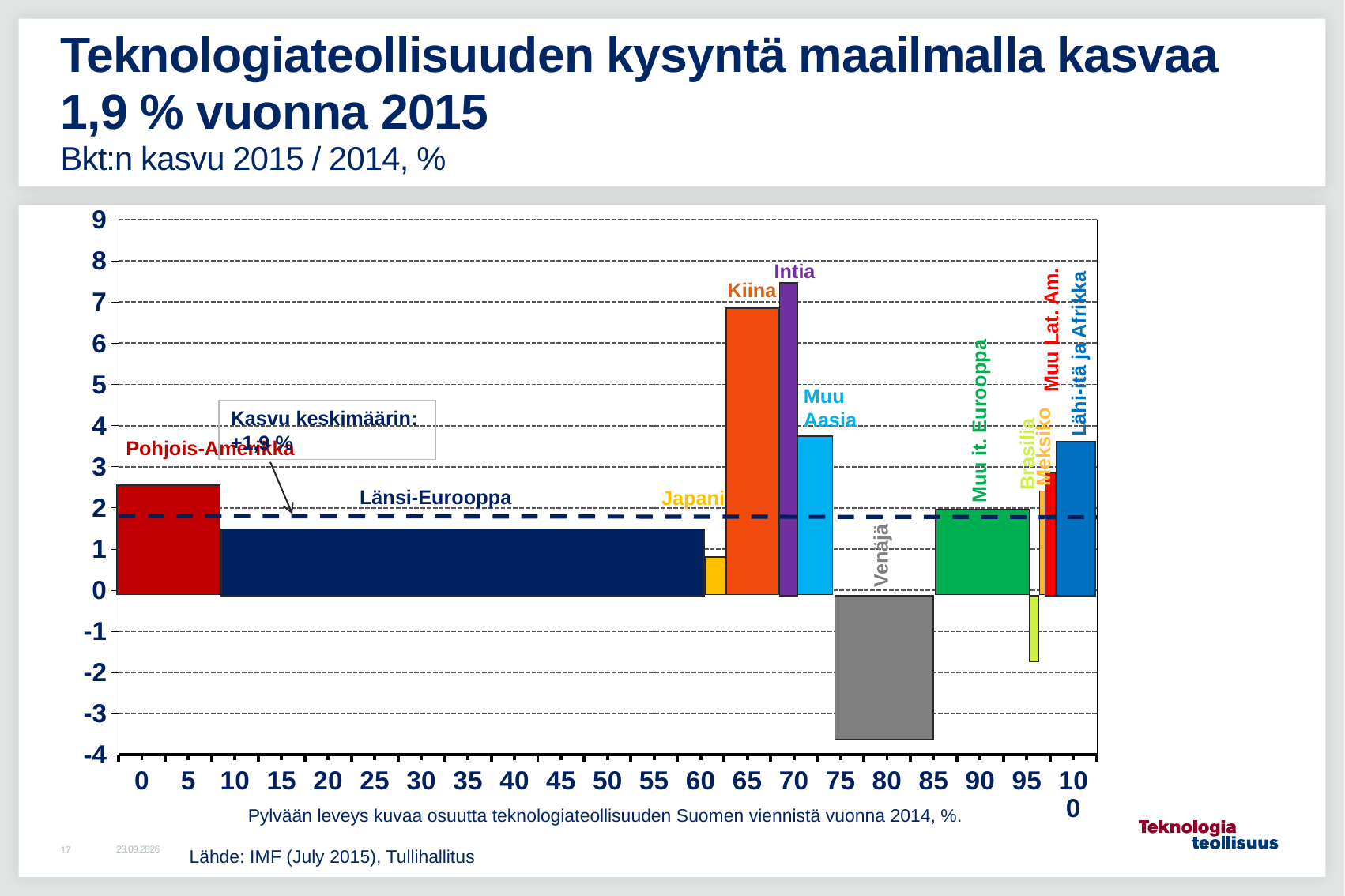
Which country or region has the highest GDP growth bar in the chart? Intia How many bars in the chart show negative growth? 2 What kind of chart is shown on the slide? bar chart Is the value for Japani greater or less than 1? less Is the value for Kiina greater or less than 6? greater How many countries or regions are plotted as bars in the chart? 12 Is the value for Venäjä greater or less than -3? less Which country or region has the lowest GDP growth bar in the chart? Venäjä Which has the larger GDP growth value, Pohjois-Amerikka or Länsi-Eurooppa? Pohjois-Amerikka What average growth value does the dashed line in the chart represent? +1,9 %